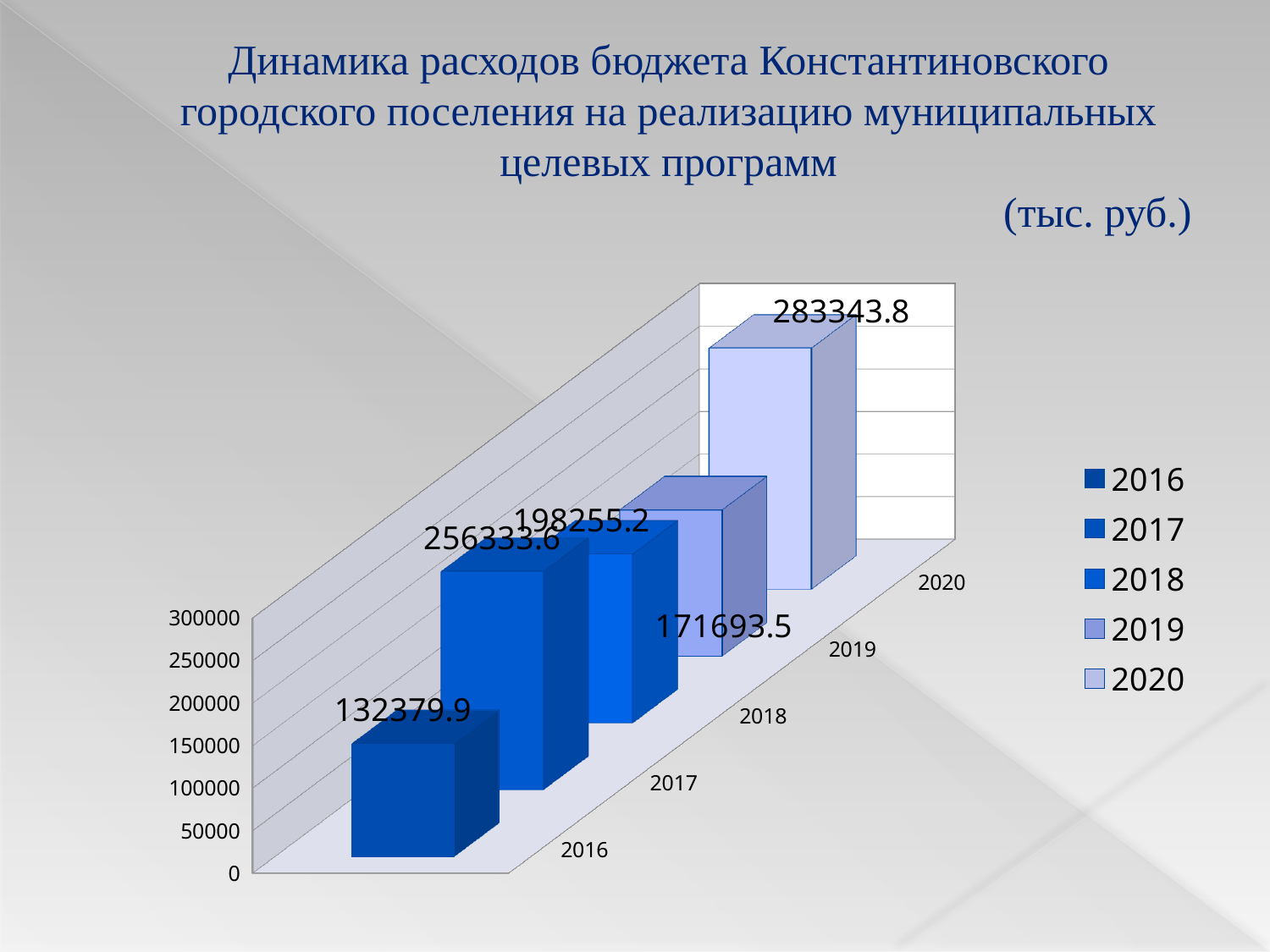
What is the value for 2020? 283343.8 What is the value for 2019? 171693.5 Does the value rise or fall from 2017 to 2018? fall How many years are shown on the chart? 5 What is the value for 2018? 198255.2 Which is larger, the value for 2018 or the value for 2019? 2018 Which year has the highest value? 2020 Which year has the lowest value? 2016 What is the value for 2017? 256333.6 What kind of chart is shown on the slide? bar chart What is the value for 2016? 132379.9 What is the difference between the values for 2020 and 2017? 27010.2